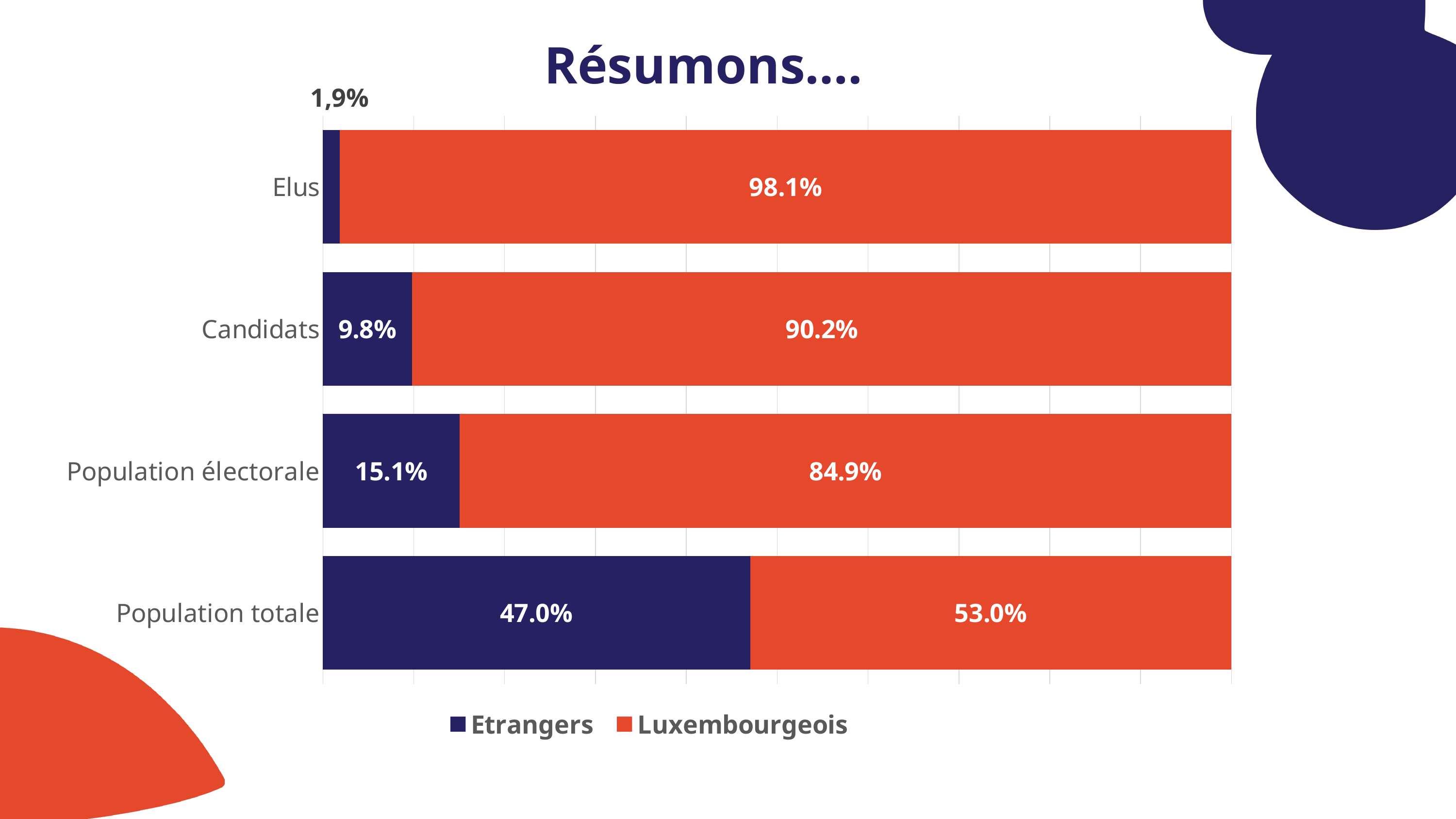
What kind of chart is shown on the slide? Stacked bar chart What is the title of the slide? Résumons.... How many categories are shown on the chart? 4 How many series does the legend list? 2 Which is larger: the Etrangers value for Population électorale or for Candidats? Population électorale What is the value for Etrangers in the Candidats category? 9.8% Which category has the lowest value for Luxembourgeois? Population totale Which category has the highest value for Etrangers? Population totale What is the value for Luxembourgeois in the Population électorale category? 84.9% What is the difference between the Luxembourgeois values for Elus and Candidats? 7.9% What is the value for Etrangers in the Population totale category? 47.0% What is the value for Luxembourgeois in the Elus category? 98.1%